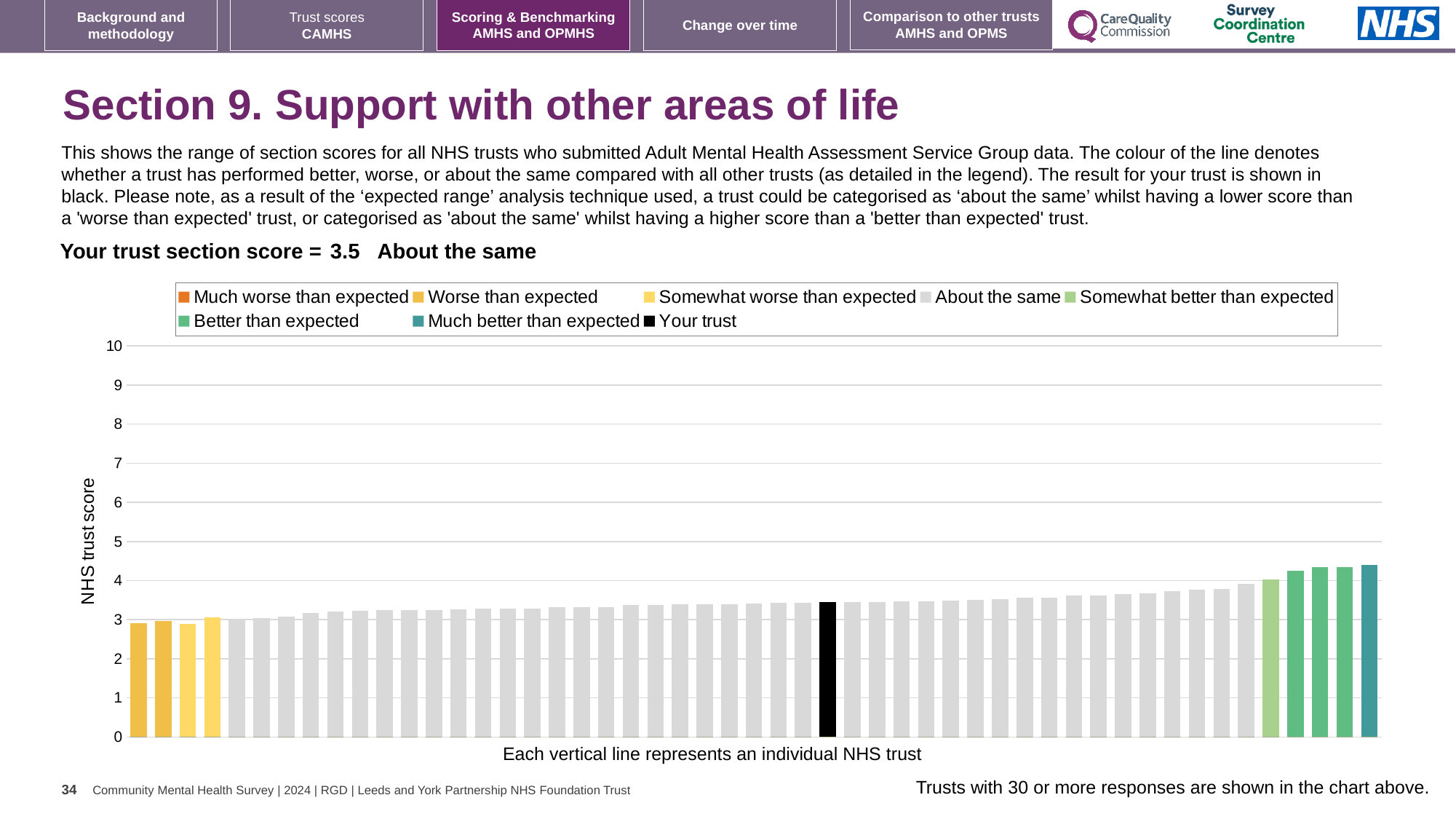
Which legend category does the tallest bar (rightmost, teal) belong to? Much better than expected What is the label on the vertical axis of the chart? NHS trust score What colour is the bar representing your trust? Black Which is higher, the black 'Your trust' bar or the leftmost bar? Your trust Do the bar values rise or fall from left to right across the chart? Rise Is the value of the leftmost bar greater or less than 2? greater What kind of chart is shown on the slide? Bar chart Is the value of the tallest bar in the chart greater or less than 5? less Is the value of the black 'Your trust' bar greater or less than 3? greater What is the section score for your trust shown on the slide? 3.5 How many entries does the chart legend list? 8